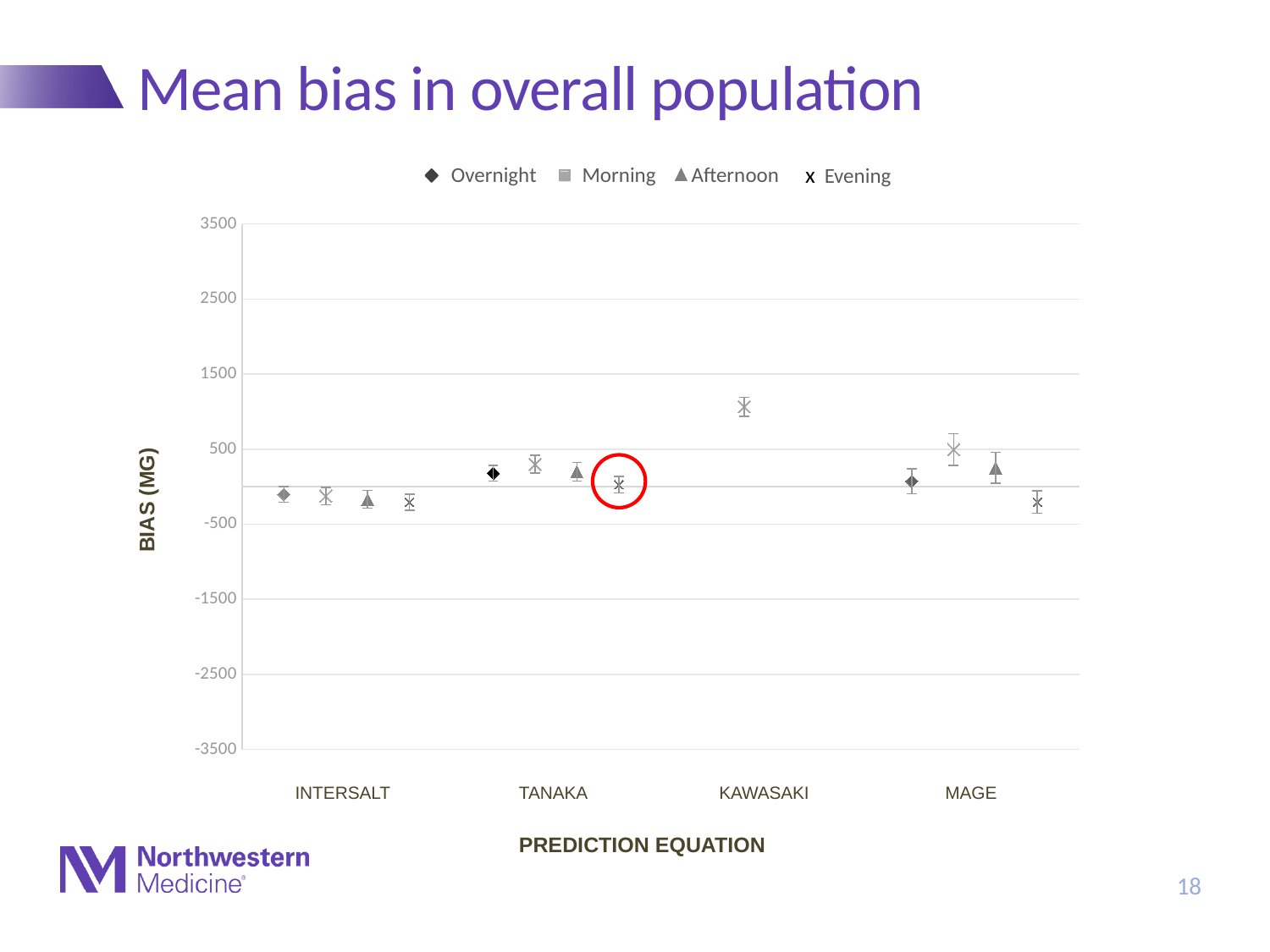
What is the title of the y axis? BIAS (MG) Which data point is highlighted with a red circle? TANAKA Evening What type of chart is shown on the slide? Scatter chart Which prediction equation has the highest Evening bias value? TANAKA Is the Evening bias value for INTERSALT greater or less than 500? less For MAGE, which is larger, the Morning bias or the Evening bias? Morning Is the Morning bias value for TANAKA greater or less than 1500? less Which prediction equation has the lowest Morning bias value? INTERSALT How many series does the legend list? 4 How many prediction equations are shown on the x axis? 4